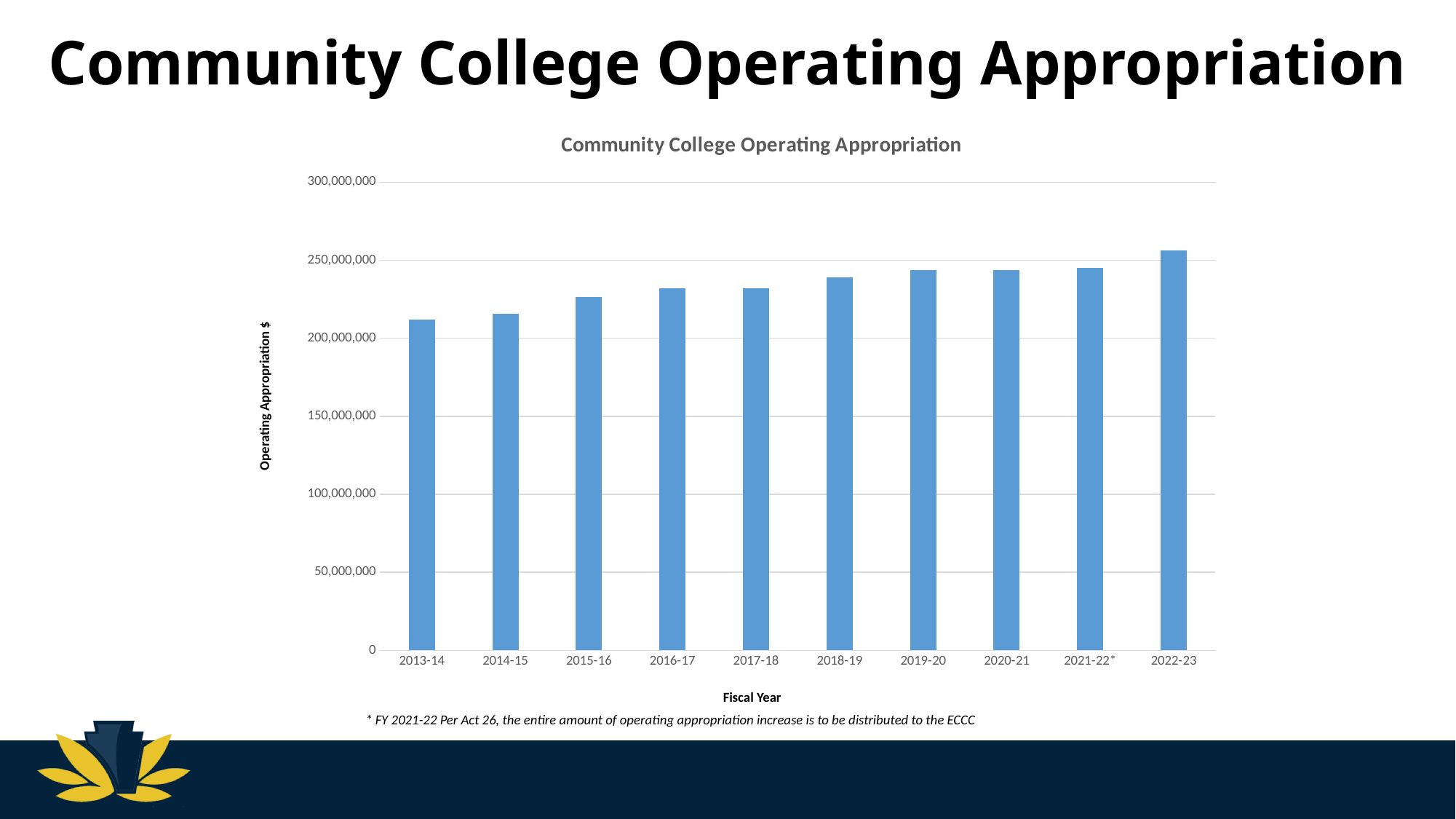
What is the label on the horizontal axis of the chart? Fiscal Year Is the operating appropriation for 2015-16 greater or less than 250,000,000? less Which is larger, the operating appropriation for 2014-15 or for 2016-17? 2016-17 Which fiscal year has the highest operating appropriation? 2022-23 Is the operating appropriation for 2013-14 greater or less than 200,000,000? greater Which fiscal year has the lowest operating appropriation? 2013-14 What kind of chart is shown on the slide? Bar chart How many fiscal years are plotted on the chart? 10 What is the label on the vertical axis of the chart? Operating Appropriation $ Do the operating appropriation values generally rise or fall from 2013-14 to 2022-23? Rise Is the operating appropriation for 2018-19 greater or less than 250,000,000? less